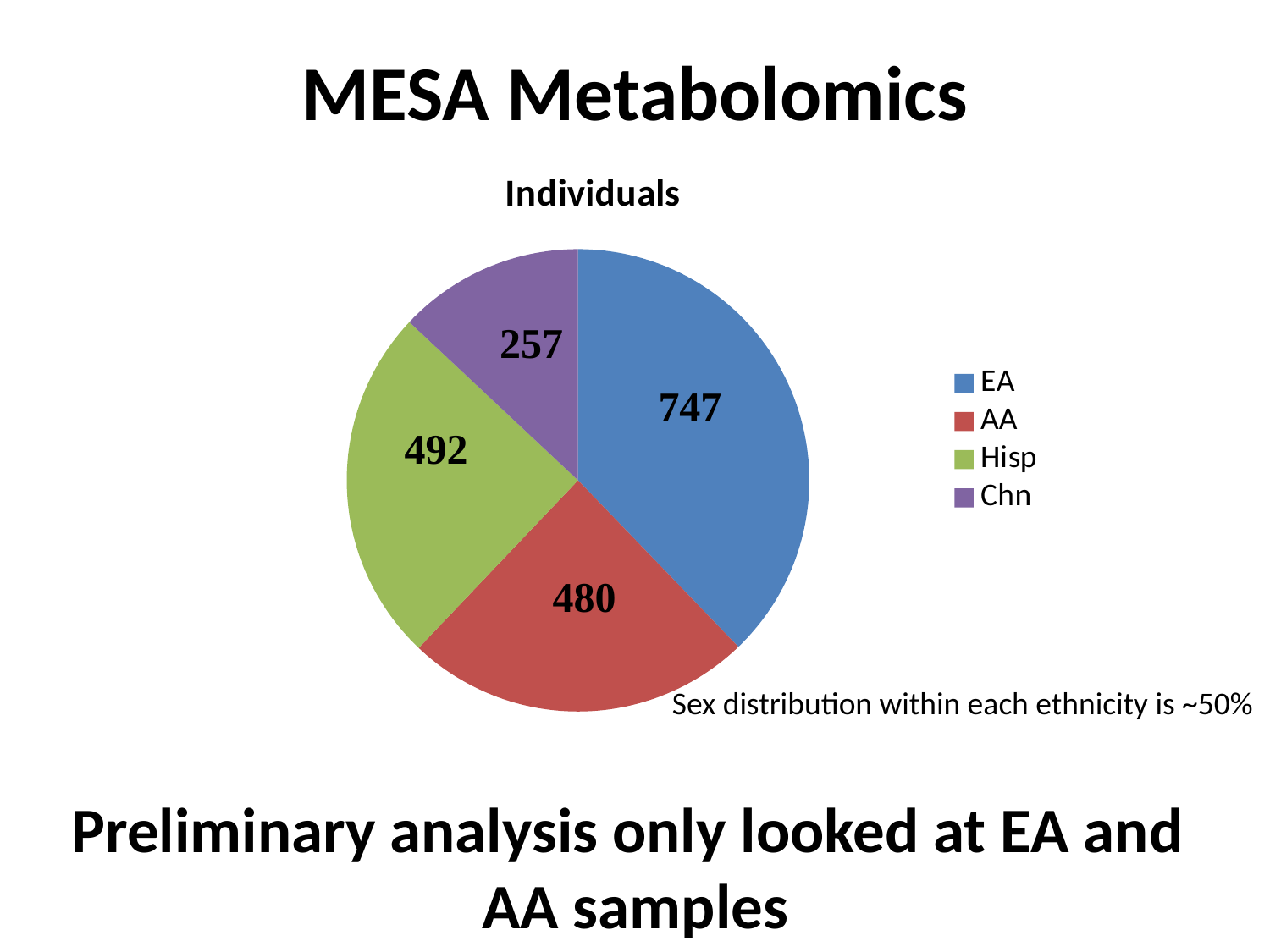
How many entries does the legend list? 4 What is the difference between the values for EA and Chn? 490 What is the total of all four slices? 1976 What is the title of the chart? Individuals What is the value for Chn? 257 What is the value for Hisp? 492 Which category has the smallest slice? Chn What type of chart is shown on the slide? pie chart Which is larger, the value for AA or the value for EA? EA Which category has the largest slice? EA How many slices does the pie chart have? 4 What is the value for EA? 747